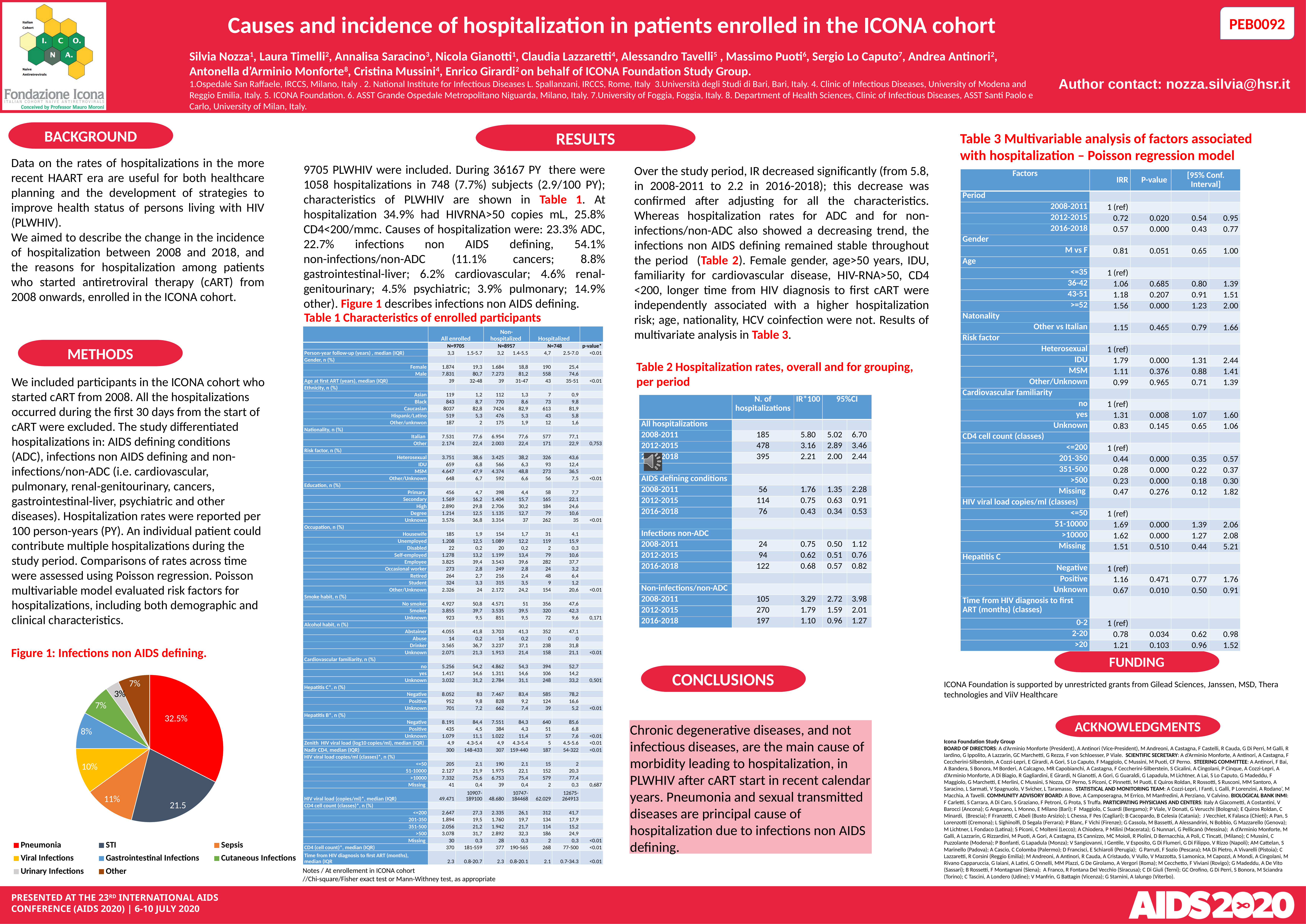
In Figure 1, which category has the smallest slice? Urinary Infections How many categories are shown in the Figure 1 pie chart? 8 What type of chart is Figure 1: Infections non AIDS defining? pie chart In Figure 1, what share is shown for Gastrointestinal Infections? 8% In Figure 1, which category has the largest slice? Pneumonia In Figure 1, what share of infections non AIDS defining is Pneumonia? 32.5% In Figure 1, what share is shown for Sepsis? 11% In Figure 1, what share is shown for Urinary Infections? 3% In Figure 1, what is the difference in percentage points between Pneumonia and STI? 11 In Figure 1, which is larger: Sepsis or Viral Infections? Sepsis In Figure 1, what value is shown for STI? 21.5 What is the title of the pie chart on the slide? Figure 1: Infections non AIDS defining.